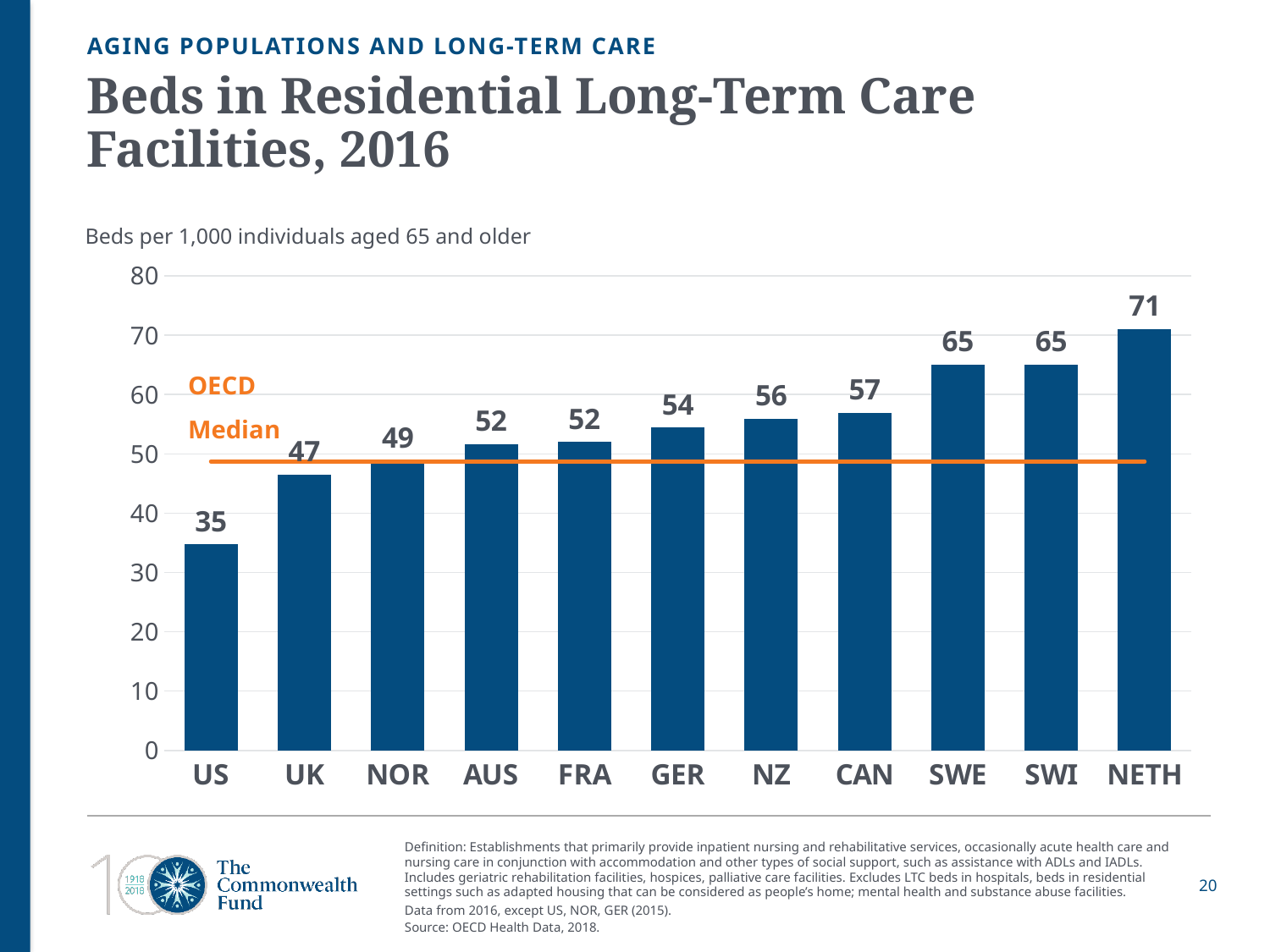
What is the value for CAN? 57 How many countries are shown on the chart? 11 What is the value for NOR? 49 Which country has the highest number of beds per 1,000 individuals aged 65 and older? NETH What does the orange horizontal line on the chart represent? OECD Median What kind of chart is shown on the slide? bar chart What is the difference between the values for NETH and the US? 36 Is the value for SWE greater or less than 60? greater Which is larger, the value for NZ or the value for FRA? NZ Which country has the lowest number of beds per 1,000 individuals aged 65 and older? US What is the difference between the values for GER and UK? 7 What is the value for the US? 35